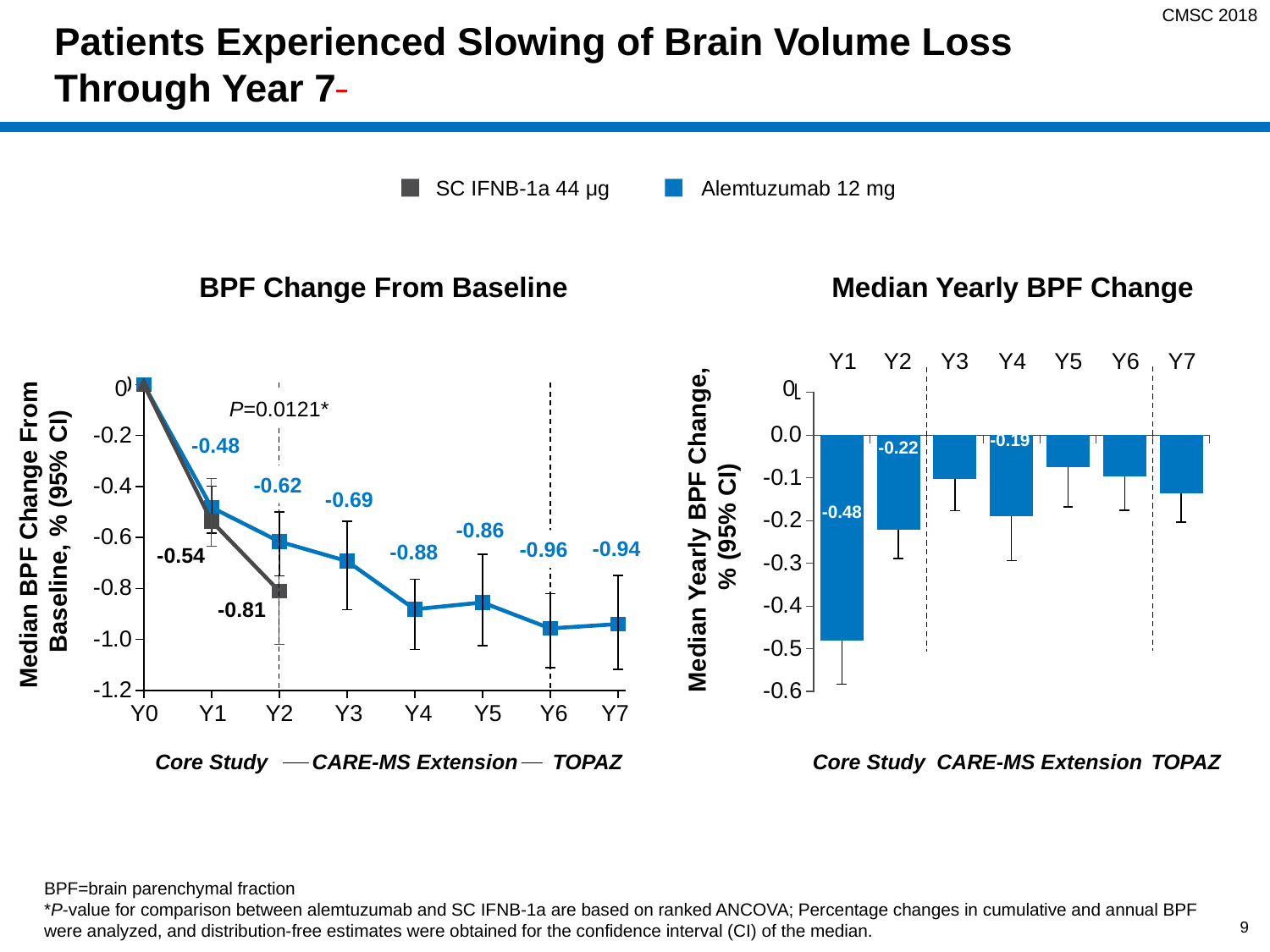
In the Median Yearly BPF Change chart, is the value for Y5 greater or less than -0.2? greater In the Median Yearly BPF Change chart, which year has the lowest (most negative) value? Y1 In the BPF Change From Baseline chart, do the Alemtuzumab 12 mg values generally rise or fall from Y0 to Y7? fall What kind of chart is the Median Yearly BPF Change chart? bar chart How many time points are shown on the x axis of the BPF Change From Baseline chart? 8 What kind of chart is the BPF Change From Baseline chart? line chart In the BPF Change From Baseline chart, what is the value for Alemtuzumab 12 mg at Y7? -0.94 In the BPF Change From Baseline chart, what is the value for SC IFNB-1a 44 µg at Y2? -0.81 How many series does the legend list for the BPF Change From Baseline chart? 2 In the BPF Change From Baseline chart, which series shows the larger decline from baseline at Y1? SC IFNB-1a 44 µg In the BPF Change From Baseline chart, what is the difference between the SC IFNB-1a 44 µg and Alemtuzumab 12 mg values at Y2? 0.19 In the Median Yearly BPF Change chart, what is the value for Y1? -0.48